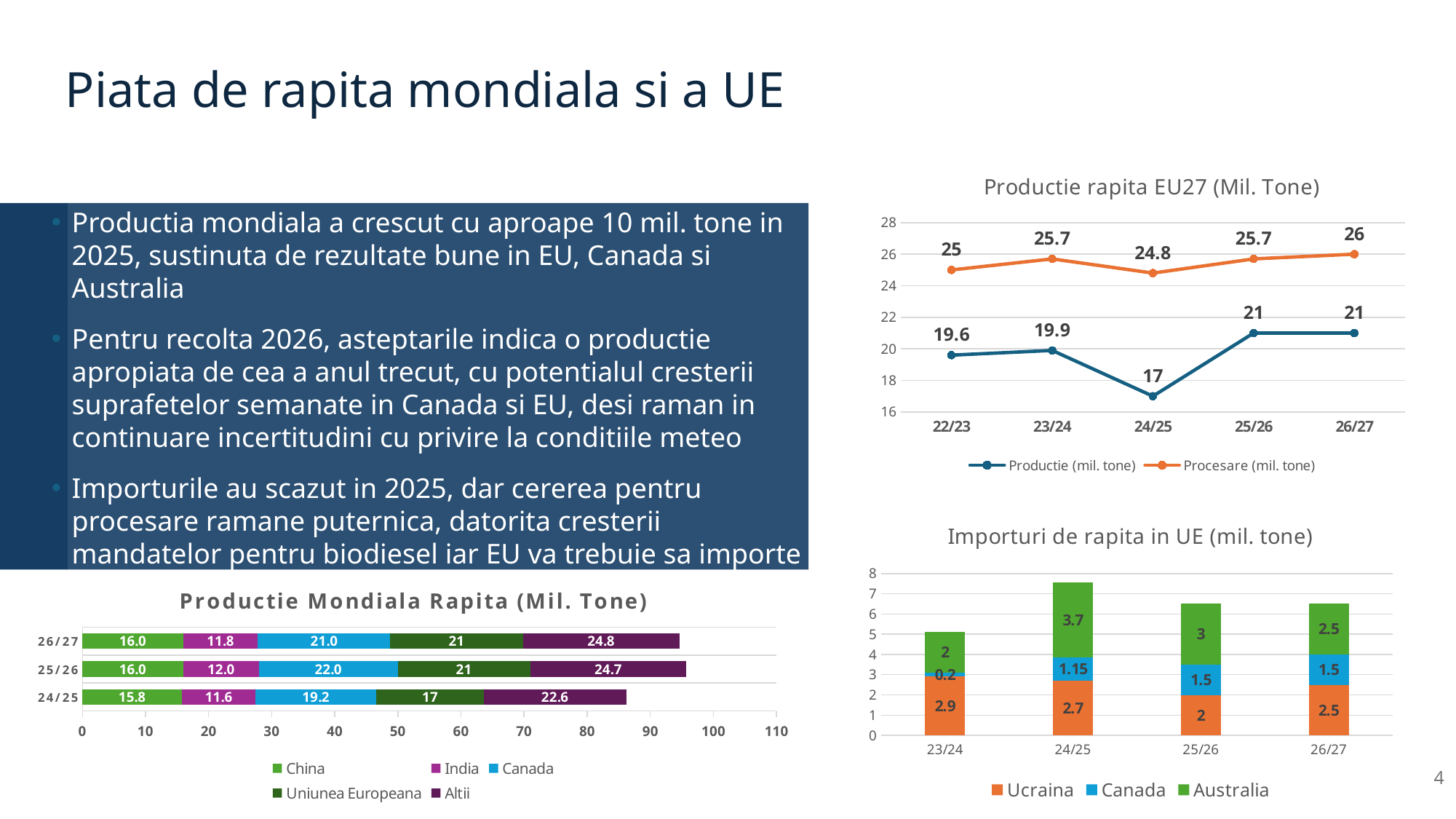
How many series does the legend of the 'Productie Mondiala Rapita (Mil. Tone)' chart list? 5 In the 'Productie rapita EU27 (Mil. Tone)' chart, which season has the lowest Productie value? 24/25 In the 'Productie rapita EU27 (Mil. Tone)' chart, what is the Productie value for 24/25? 17 How many series does the legend of the 'Productie rapita EU27 (Mil. Tone)' chart list? 2 In the 'Productie rapita EU27 (Mil. Tone)' chart, what is the difference between Procesare and Productie in 24/25? 7.8 In the 'Importuri de rapita in UE (mil. tone)' chart, what is the value for Australia in 24/25? 3.7 What kind of chart is 'Productie rapita EU27 (Mil. Tone)'? Line chart In the 'Productie Mondiala Rapita (Mil. Tone)' chart, what is the value for Canada in 25/26? 22.0 In the 'Productie Mondiala Rapita (Mil. Tone)' chart, what is the total of the stacked bar for 24/25? 86.2 In the 'Importuri de rapita in UE (mil. tone)' chart, what is the total of the stacked bar for 23/24? 5.1 In the 'Productie Mondiala Rapita (Mil. Tone)' chart, which series has the largest value in 26/27? Altii In the 'Productie rapita EU27 (Mil. Tone)' chart, what is the Procesare value for 26/27? 26